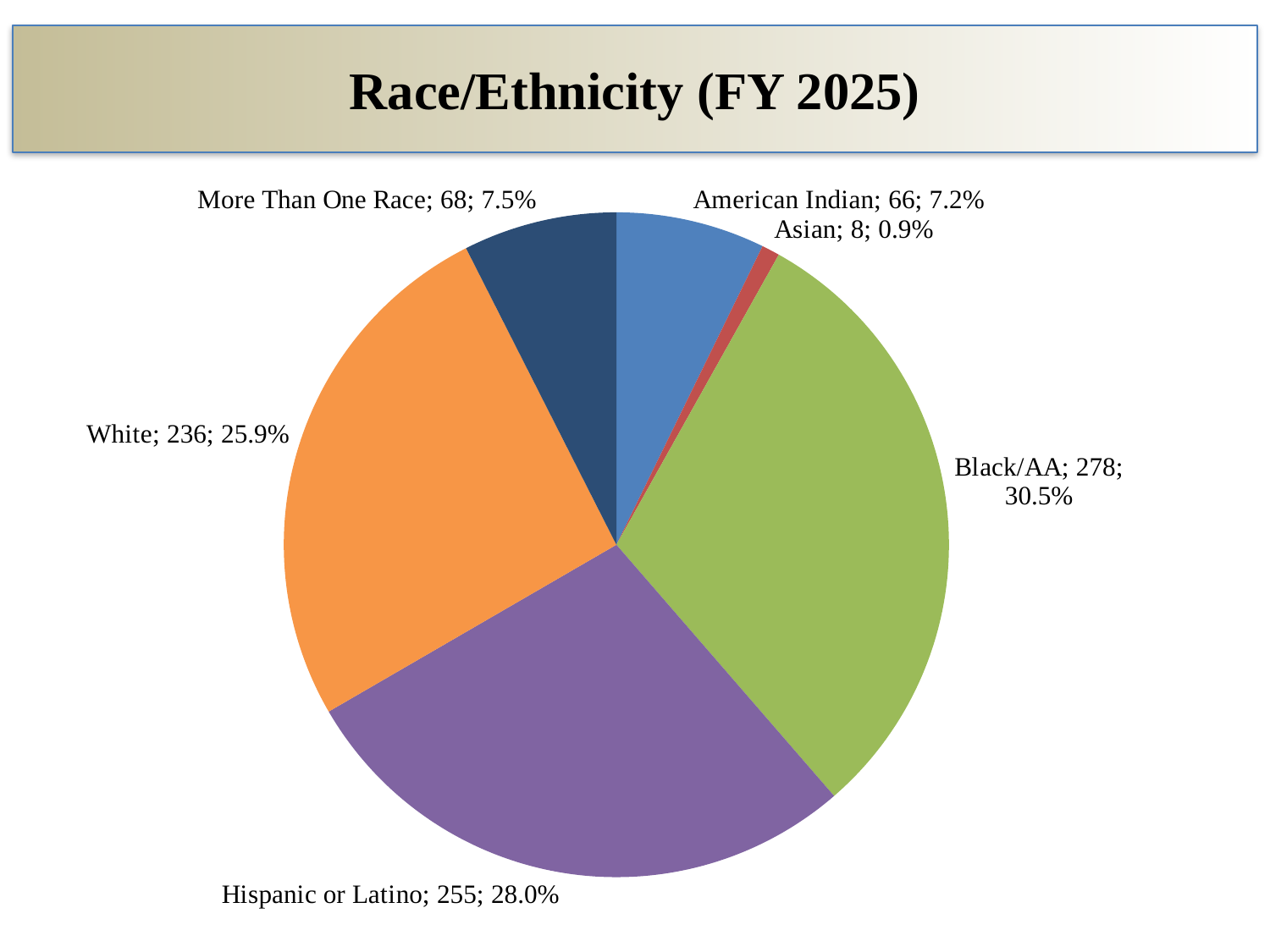
Which is larger, the count for More Than One Race or the count for American Indian? More Than One Race What is the count for Hispanic or Latino? 255 What is the difference in count between White and More Than One Race? 168 What percentage share does White have? 25.9% What kind of chart is shown on the slide? pie chart What is the difference in count between Black/AA and Hispanic or Latino? 23 What is the count for Black/AA? 278 What percentage share does Asian have? 0.9% Which category has the smallest slice? Asian Which category has the largest slice? Black/AA What is the title of the chart? Race/Ethnicity (FY 2025) How many slices does the pie chart have? 6